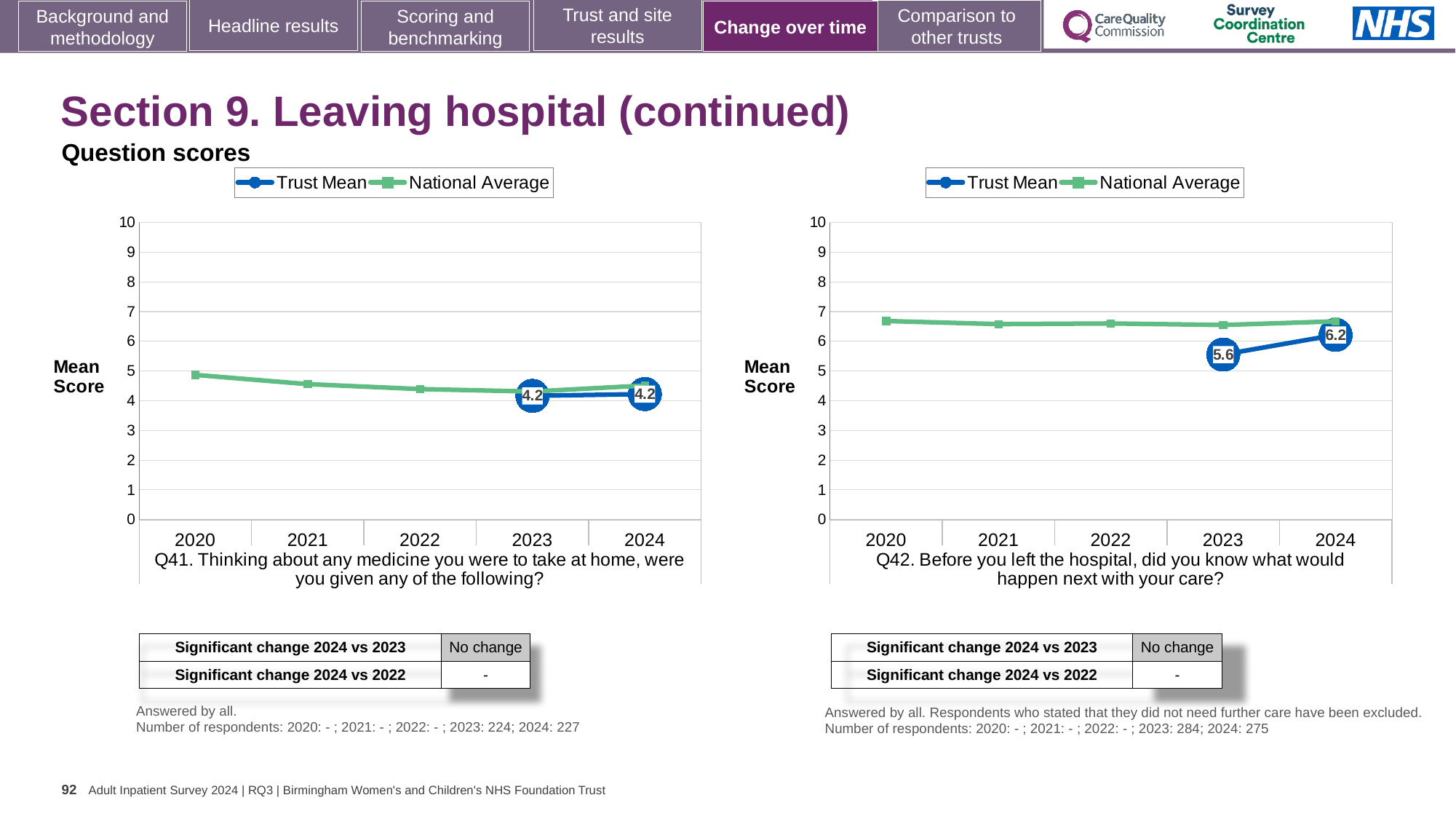
In the Q41 chart on the left, what is the Trust Mean score for 2023? 4.2 In the Q42 chart on the right, what is the Trust Mean score for 2023? 5.6 What type of chart is used for Q41 on the left? Line chart In the Q41 chart on the left, is the National Average value for 2020 greater or less than 4? greater In the Q42 chart on the right, does the Trust Mean rise or fall from 2023 to 2024? Rise In the Q41 chart on the left, what is the Trust Mean score for 2024? 4.2 In the Q42 chart on the right, which year has the higher Trust Mean score, 2023 or 2024? 2024 In the Q42 chart on the right, by how much did the Trust Mean score increase from 2023 to 2024? 0.6 In the Q42 chart on the right, what is the Trust Mean score for 2024? 6.2 How many series does the legend of the Q42 chart on the right list? 2 In the Q42 chart on the right, is the National Average value for 2020 greater or less than 6? greater How many years are shown on the x axis of the Q41 chart on the left? 5